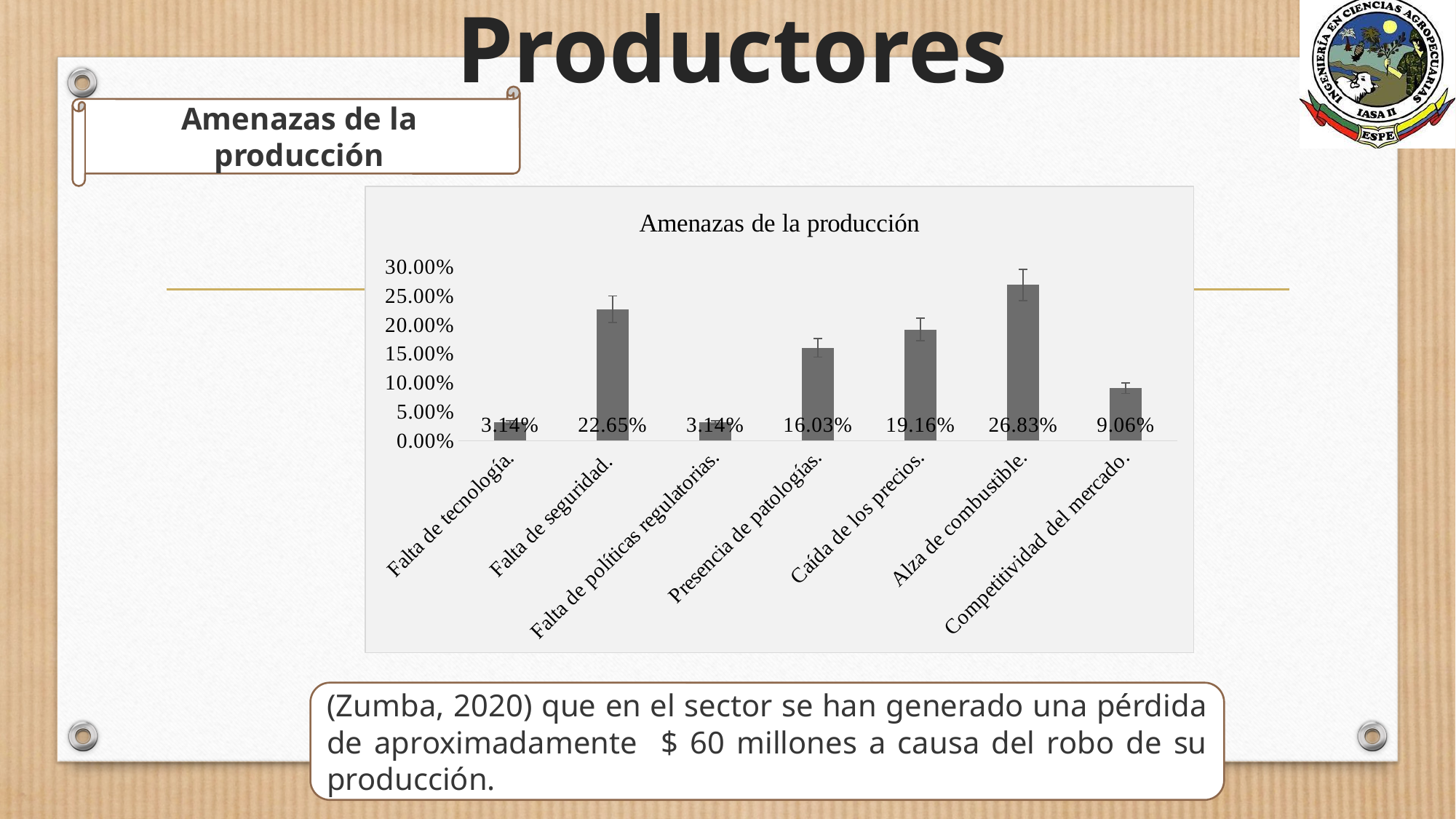
What is the title of the chart? Amenazas de la producción What kind of chart is shown? bar chart What is the difference between Alza de combustible and Falta de seguridad? 4.18% Which is larger, Caída de los precios or Presencia de patologías? Caída de los precios What is the value for Alza de combustible? 26.83% What is the value for Presencia de patologías? 16.03% What is the value for Competitividad del mercado? 9.06% What is the lowest value shown in the chart? 3.14% Which category has the highest value? Alza de combustible Is the value for Caída de los precios greater or less than 20.00%? less What is the value for Falta de seguridad? 22.65% How many categories are shown in the chart? 7